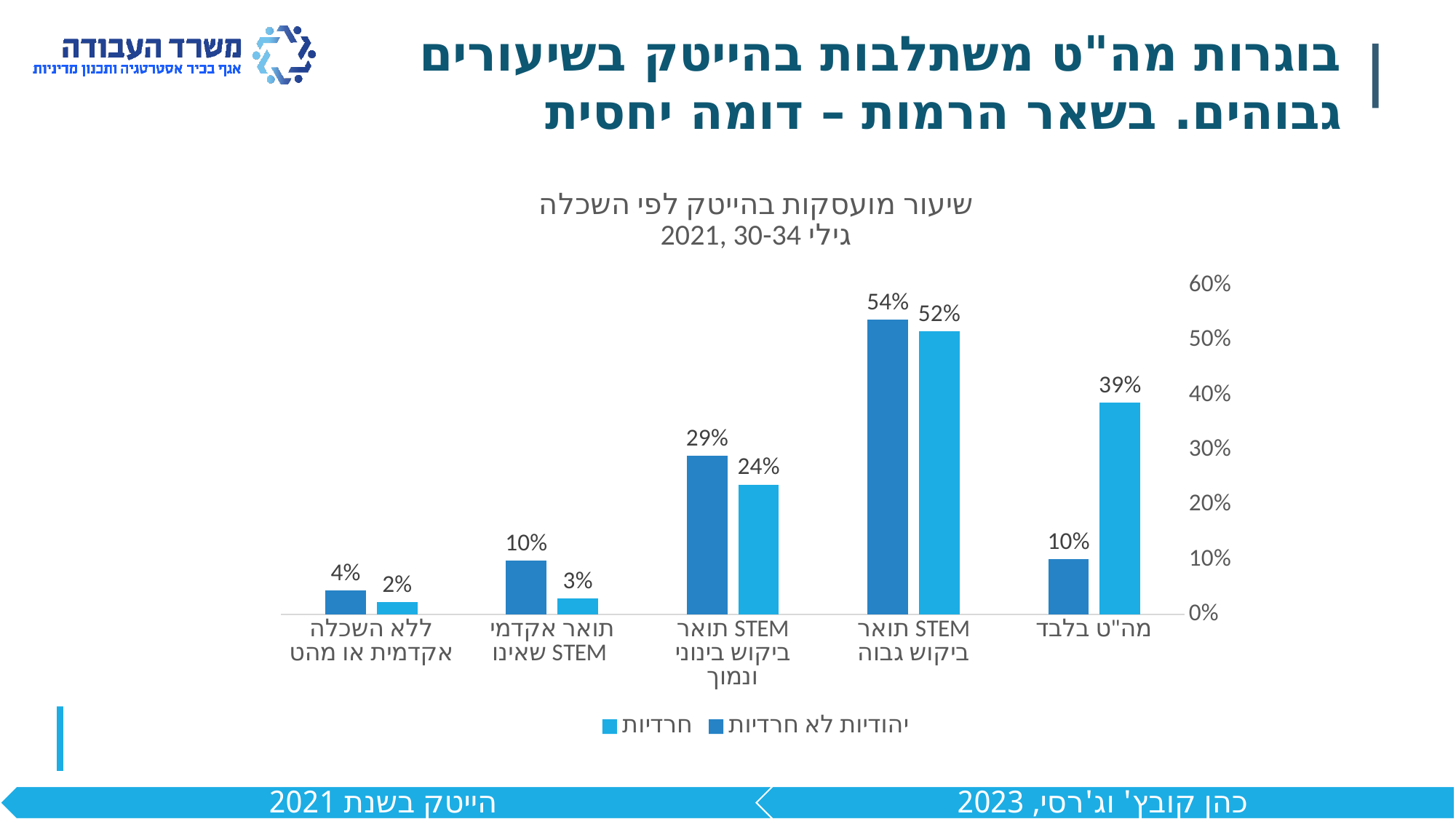
Which category has the highest value for חרדיות? תואר STEM ביקוש גבוה How many series does the legend list? 2 How many categories are shown on the x axis? 5 Which category has the lowest value for יהודיות לא חרדיות? ללא השכלה אקדמית או מהט What is the difference between the חרדיות and יהודיות לא חרדיות values in the מה"ט בלבד category? 29% What is the value for יהודיות לא חרדיות in the מה"ט בלבד category? 10% What is the title of the chart? שיעור מועסקות בהייטק לפי השכלה גילי 30-34, 2021 What is the value for חרדיות in the תואר אקדמי שאינו STEM category? 3% What is the value for חרדיות in the מה"ט בלבד category? 39% In the תואר STEM ביקוש בינוני ונמוך category, which series has the larger value: יהודיות לא חרדיות or חרדיות? יהודיות לא חרדיות What kind of chart is shown on the slide? Bar chart What is the value for יהודיות לא חרדיות in the תואר STEM ביקוש גבוה category? 54%